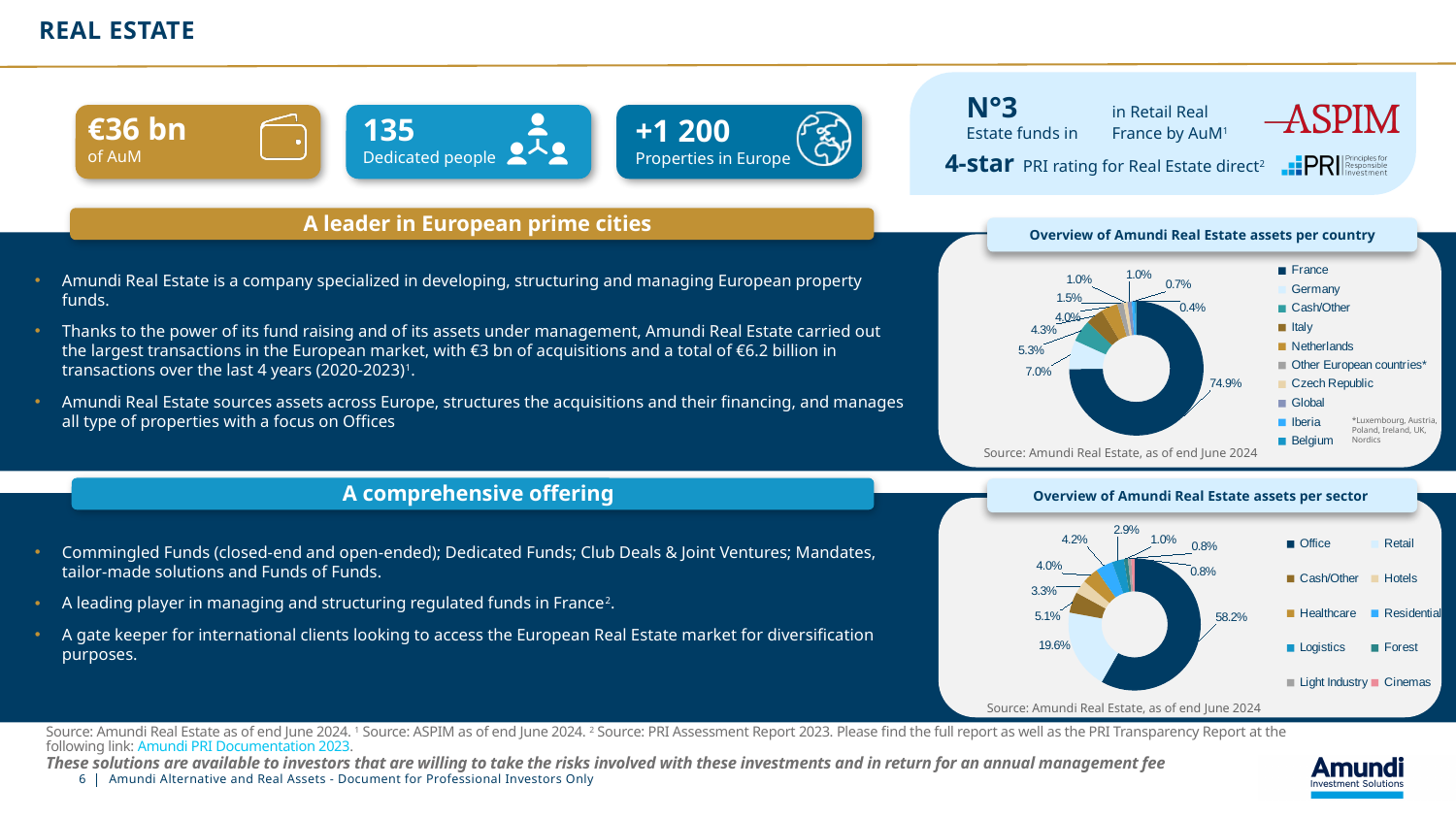
In the 'Overview of Amundi Real Estate assets per country' chart, what share of assets is in Germany? 7.0% What kind of chart is the 'Overview of Amundi Real Estate assets per country' chart? Doughnut (pie) chart How many sectors does the legend of the 'Overview of Amundi Real Estate assets per sector' chart list? 10 How many entries does the legend of the 'Overview of Amundi Real Estate assets per country' chart list? 10 In the 'Overview of Amundi Real Estate assets per sector' chart, what is the difference between the Office share and the Retail share? 38.6% In the 'Overview of Amundi Real Estate assets per country' chart, which country has the largest share of assets? France In the 'Overview of Amundi Real Estate assets per country' chart, what share of assets is in France? 74.9% In the 'Overview of Amundi Real Estate assets per sector' chart, which sector has the largest share of assets? Office In the 'Overview of Amundi Real Estate assets per sector' chart, what share of assets is in Retail? 19.6% In the 'Overview of Amundi Real Estate assets per sector' chart, what share of assets is in Office? 58.2% In the 'Overview of Amundi Real Estate assets per sector' chart, which is larger, the Office share or the Retail share? Office In the 'Overview of Amundi Real Estate assets per country' chart, is the share for France greater or less than 50%? greater